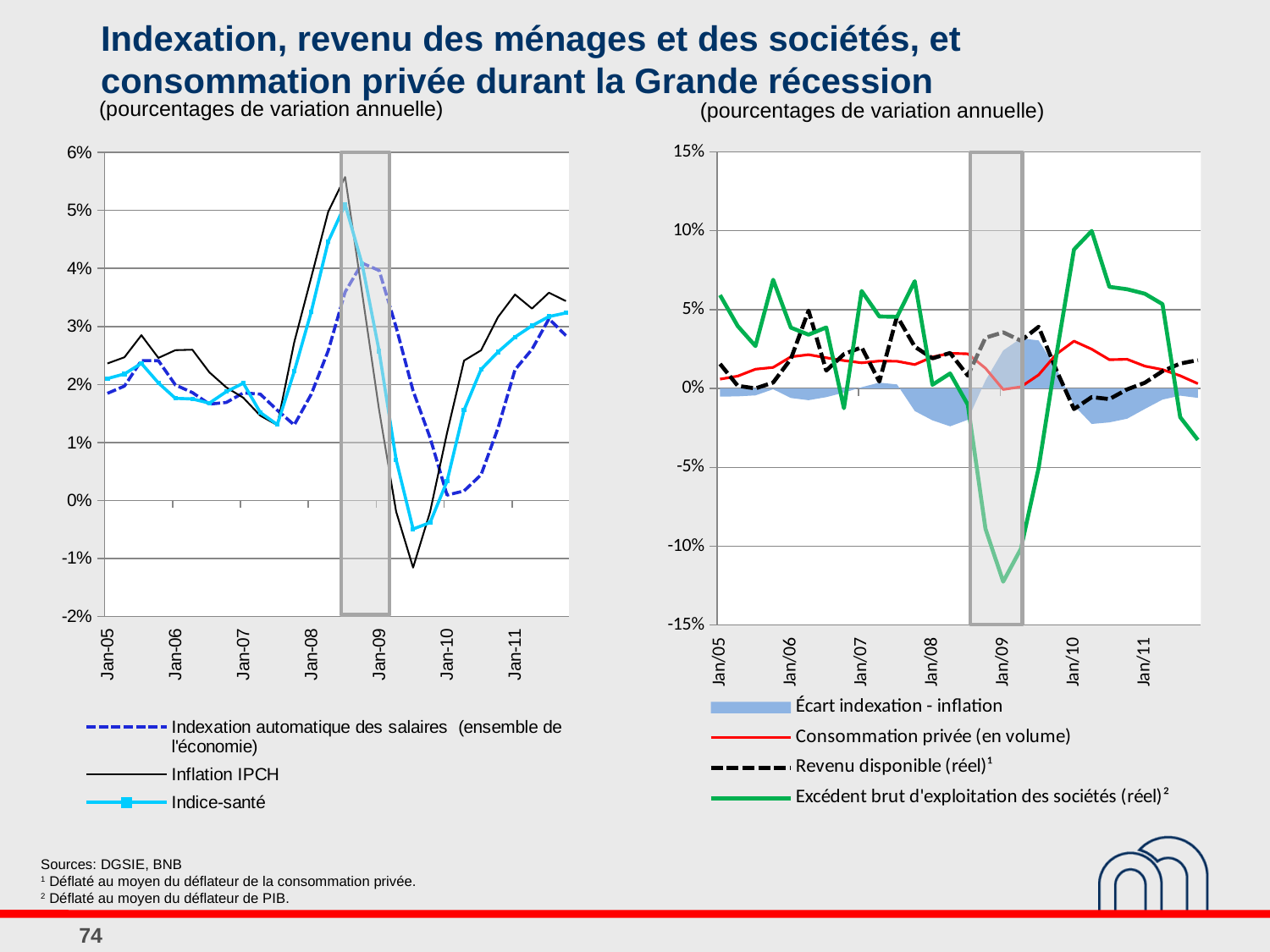
In the left chart, which series is drawn as a dashed blue line? Indexation automatique des salaires (ensemble de l'économie) In the right chart, is the lowest value of Excédent brut d'exploitation des sociétés (réel) in 2009 greater or less than -10%? less What kind of chart is the left chart on the slide? Line chart In the right chart, at Jan-10, which is larger: Excédent brut d'exploitation des sociétés (réel) or Consommation privée (en volume)? Excédent brut d'exploitation des sociétés (réel) What kind of chart is the right chart on the slide? Combination area and line chart In the right chart, is the peak value of Excédent brut d'exploitation des sociétés (réel) around Jan-10 greater or less than 5%? greater In the left chart, does Inflation IPCH rise or fall between Jan-08 and mid-2008? rise How many series does the legend of the left chart list? 3 How many series does the legend of the right chart list? 4 In the left chart, is the lowest value of Inflation IPCH in 2009 greater or less than 0%? less In the right chart, does Excédent brut d'exploitation des sociétés (réel) rise or fall between Jan-10 and Jan-11? fall